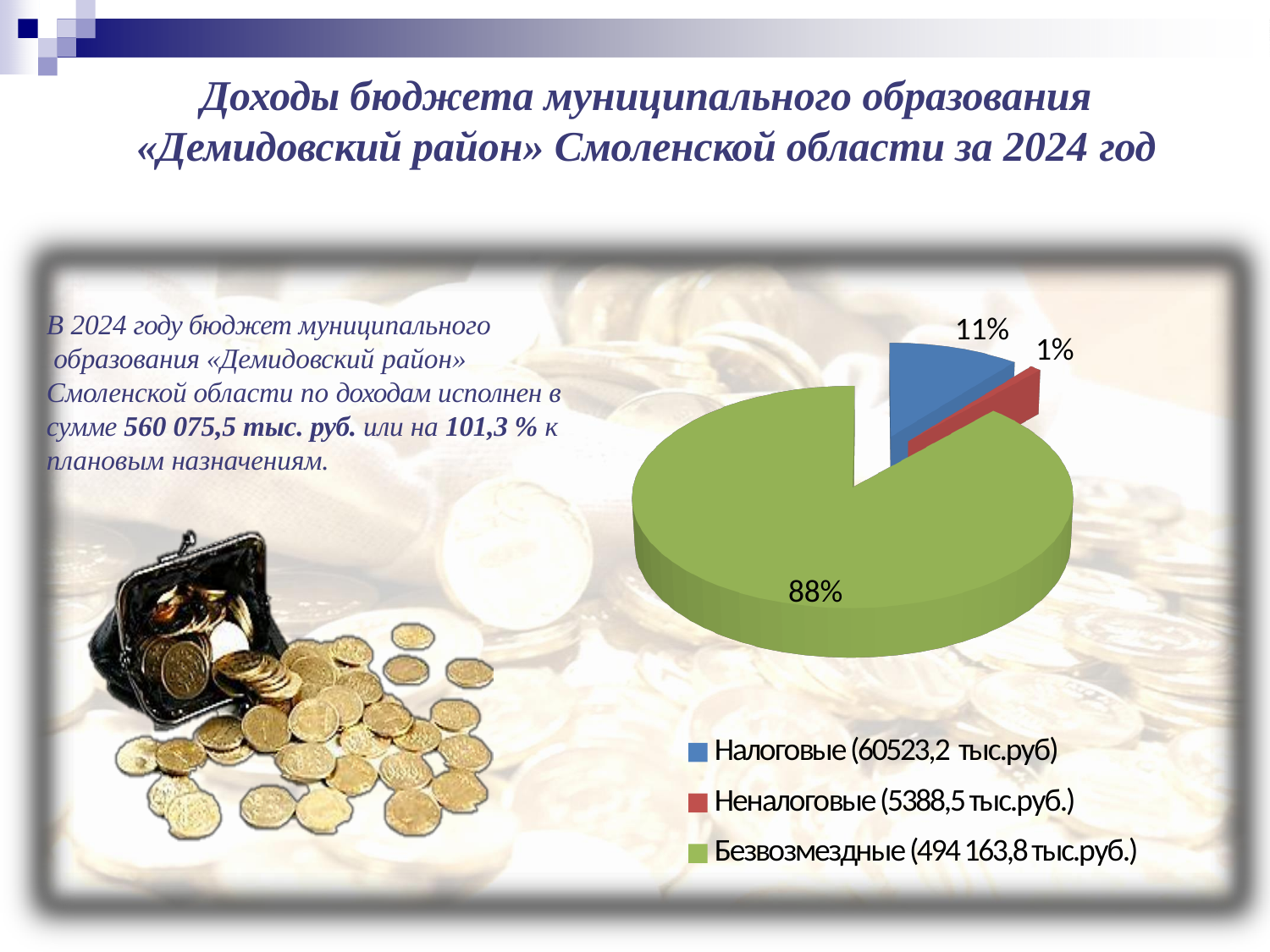
Which category has the largest slice of the pie? Безвозмездные What amount in тыс.руб. does the legend give for Неналоговые? 5388,5 тыс.руб. What share of the pie does the Налоговые slice represent? 11% How many slices does the pie chart have? 3 What colour is the Безвозмездные slice in the pie chart? green Which slice is larger, Налоговые or Неналоговые? Налоговые Which category has the smallest slice of the pie? Неналоговые How many entries does the legend of the pie chart list? 3 What share of the pie does the Безвозмездные slice represent? 88% What kind of chart is shown on the slide? pie chart What is the difference in percentage points between the Безвозмездные and Налоговые slices? 77 What share of the pie does the Неналоговые slice represent? 1%